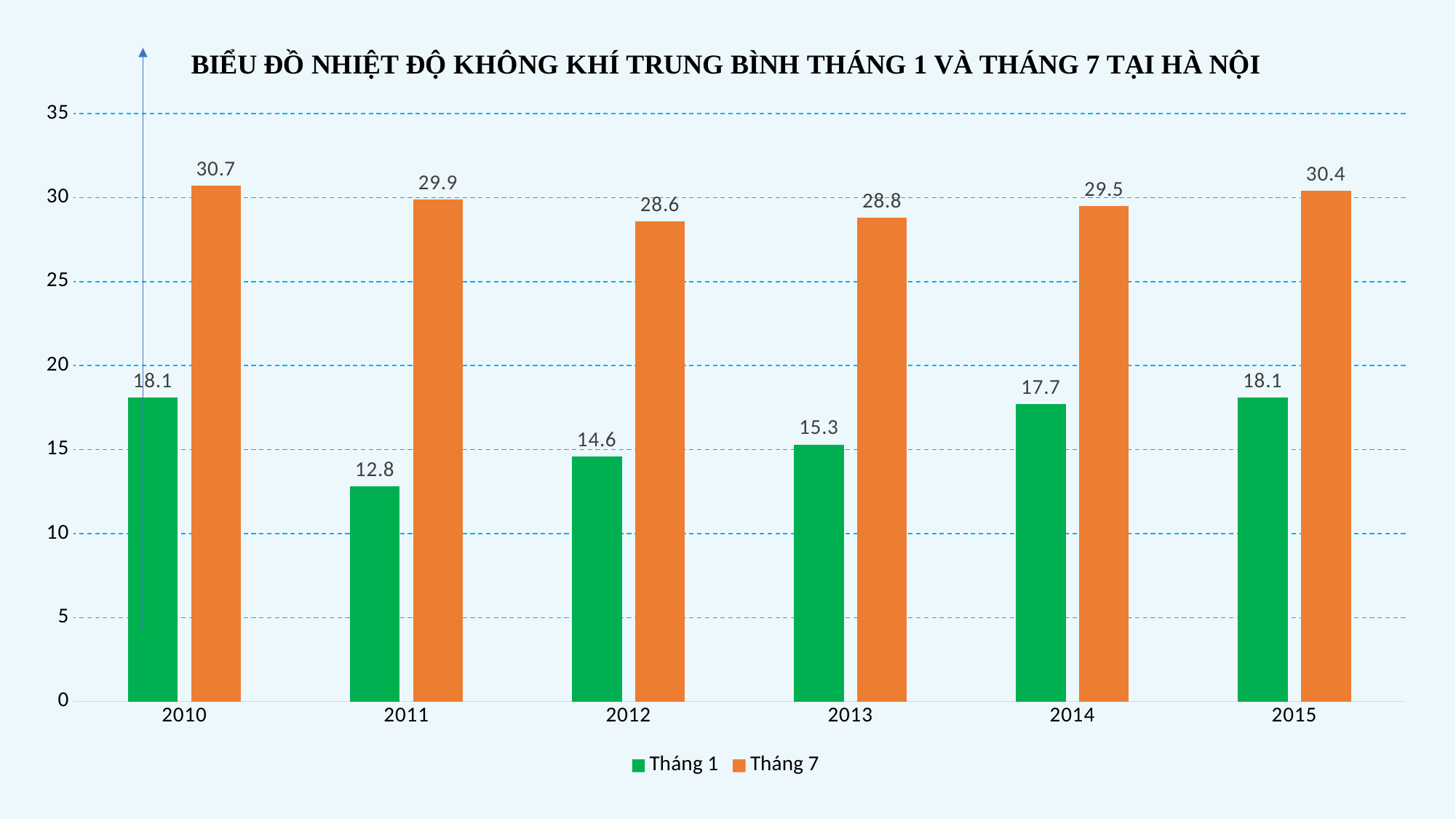
How many years are shown on the x axis? 6 Which year has the lowest Tháng 1 value? 2011 Do the Tháng 1 values rise or fall from 2011 to 2015? rise What is the difference between the Tháng 7 and Tháng 1 values in 2010? 12.6 Which year has the highest Tháng 7 value? 2010 How many series does the legend list? 2 Which is larger, the Tháng 1 value for 2012 or for 2013? 2013 What is the Tháng 1 value for 2014? 17.7 What type of chart is shown on the slide? bar chart Which year has the lowest Tháng 7 value? 2012 What is the Tháng 1 value for 2011? 12.8 What is the Tháng 7 value for 2013? 28.8